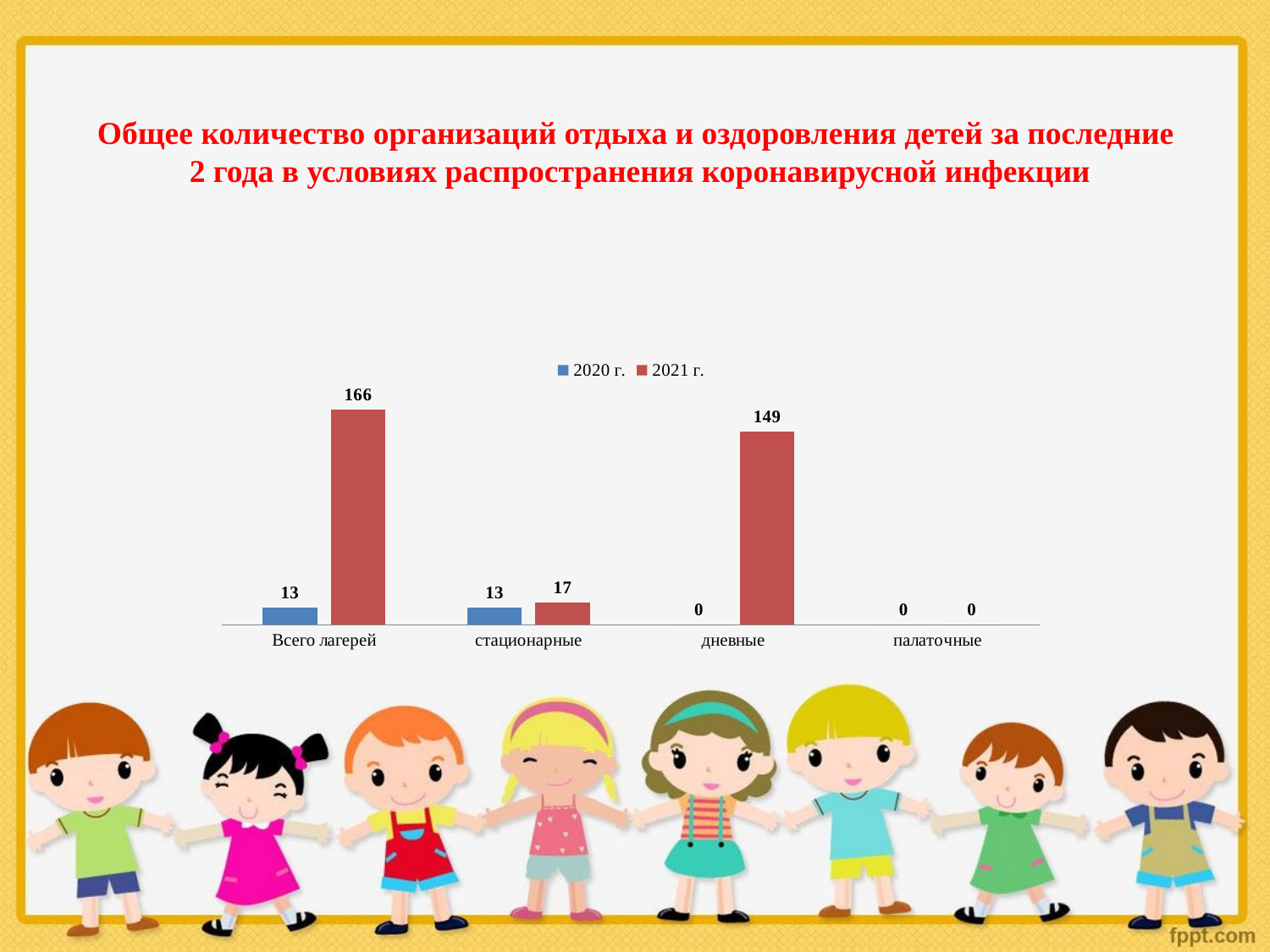
What is the difference between the 2021 г. values for 'Всего лагерей' and 'дневные'? 17 What is the difference between the 2021 г. and 2020 г. values for 'Всего лагерей'? 153 How many series does the legend list? 2 What is the value for 'Всего лагерей' in the 2021 г. series? 166 Which category has the lowest value in the 2021 г. series? палаточные Which is larger: the 2021 г. value for 'стационарные' or the 2020 г. value for 'стационарные'? 2021 г. What is the value for 'стационарные' in the 2021 г. series? 17 Which category has the highest value in the 2021 г. series? Всего лагерей What kind of chart is shown on the slide? bar chart How many categories are shown on the x axis? 4 What is the value for 'дневные' in the 2020 г. series? 0 What is the value for 'Всего лагерей' in the 2020 г. series? 13